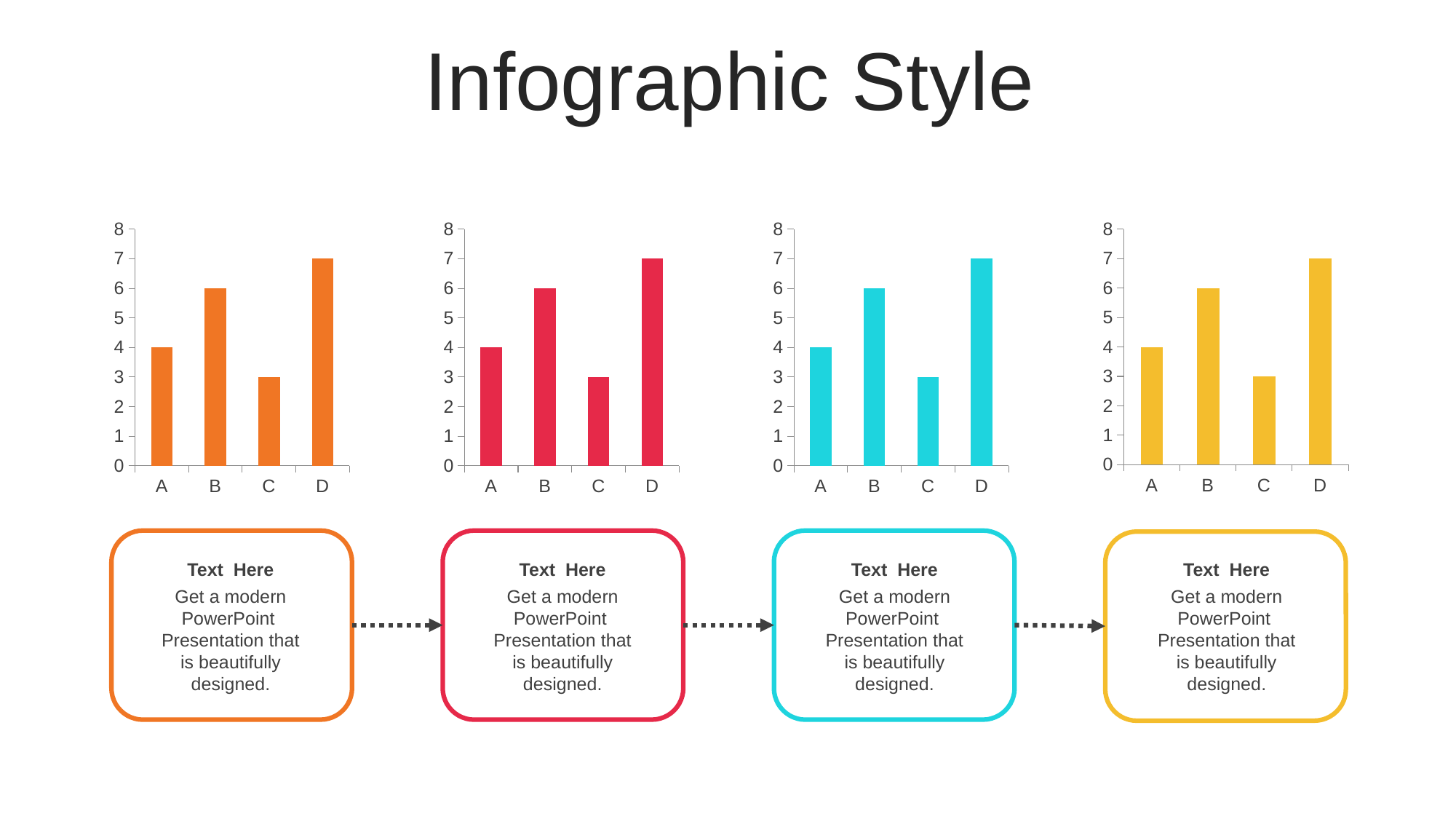
What colour are the bars in the third chart from the left? cyan In the second chart from the left (red), what is the value for category A? 4 How many categories are shown in the rightmost (yellow) chart? 4 How many bar charts are on the slide? 4 In the rightmost (yellow) chart, which category has the highest value? D In the leftmost (orange) chart, what is the difference between the values for D and C? 4 In the third chart from the left (cyan), is the value for B greater or less than 5? greater In the second chart from the left (red), which is larger, the value for B or the value for A? B In the leftmost (orange) chart, what is the value for category D? 7 In the third chart from the left (cyan), which category has the lowest value? C In the rightmost (yellow) chart, what is the value for category C? 3 What kind of chart is the leftmost (orange) chart? bar chart